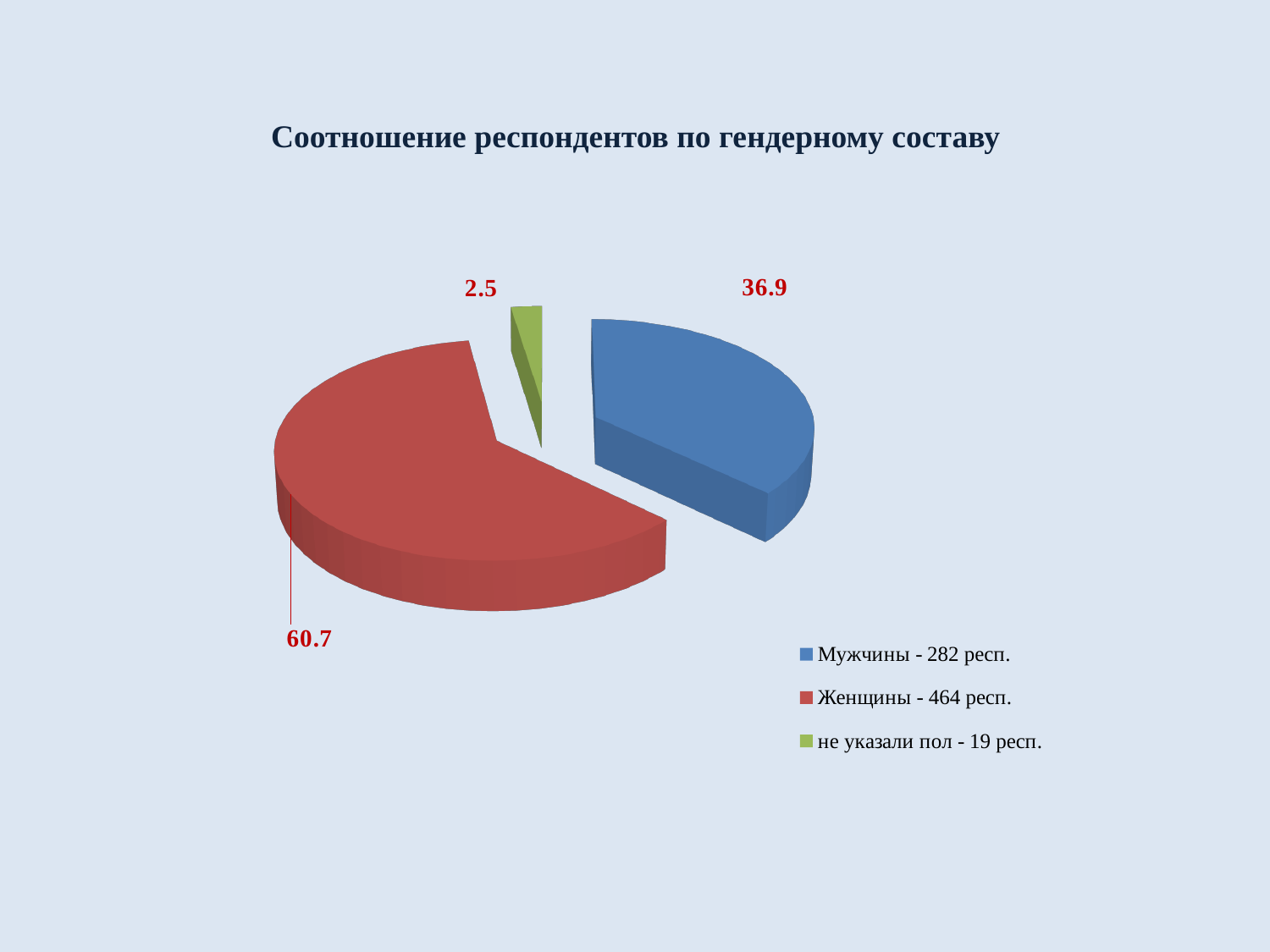
How many entries does the legend list? 3 What is the difference between the values for "Женщины - 464 респ." and "Мужчины - 282 респ."? 23.8 Which slice has the smallest value? не указали пол - 19 респ. Which is larger, the value for "Мужчины - 282 респ." or the value for "не указали пол - 19 респ."? Мужчины - 282 респ. How many slices does the pie chart have? 3 What kind of chart is shown on the slide? pie chart What value is shown for the slice labelled "Мужчины - 282 респ."? 36.9 What is the title of the chart? Соотношение респондентов по гендерному составу Which slice has the largest value? Женщины - 464 респ. What value is shown for the slice labelled "не указали пол - 19 респ."? 2.5 What value is shown for the slice labelled "Женщины - 464 респ."? 60.7 What colour is the slice for "Женщины - 464 респ."? red